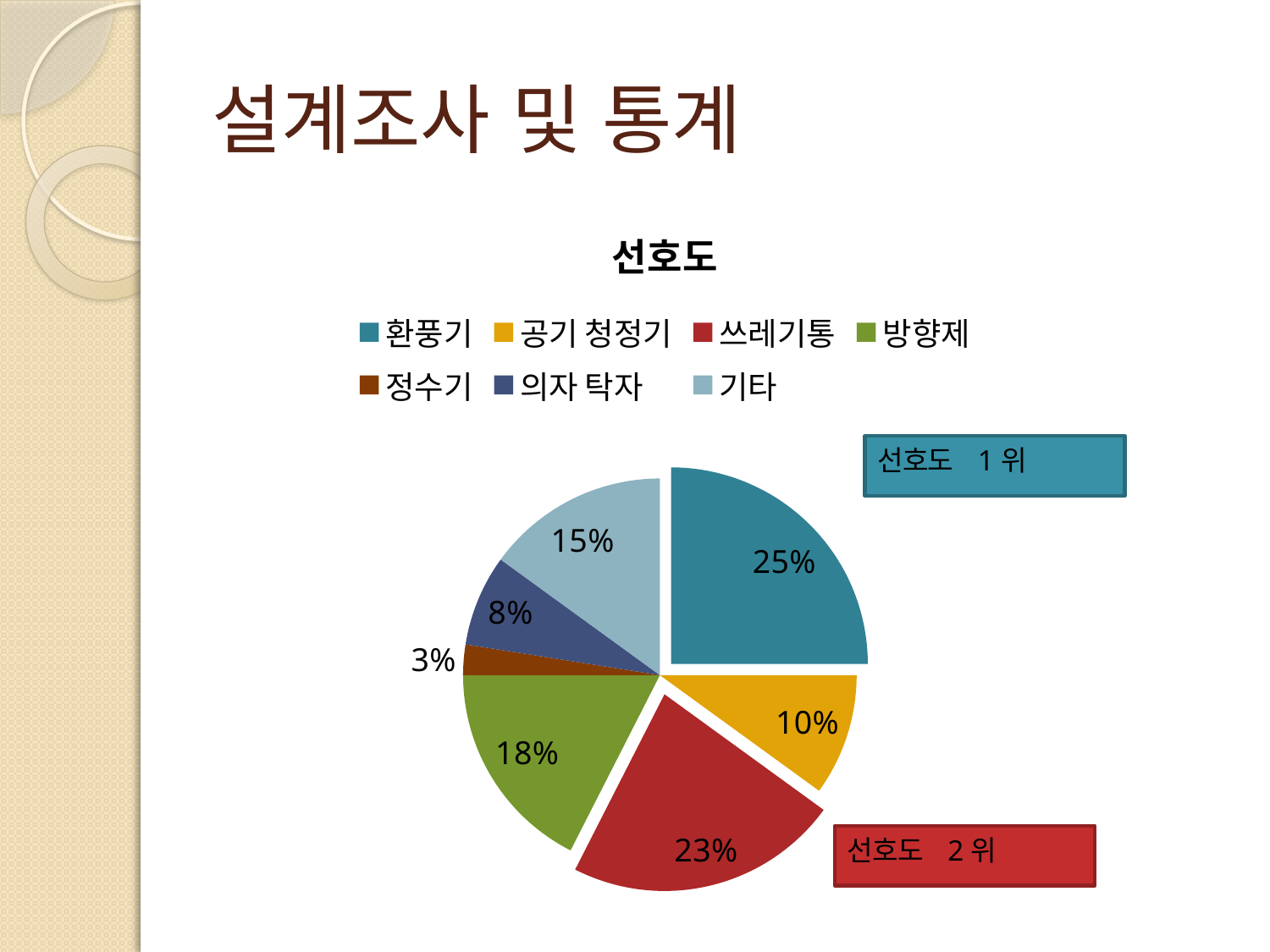
What kind of chart is shown on the slide? pie chart What is the title of the chart? 선호도 How many categories does the legend list? 7 What is the value shown for 방향제? 18% Which category has the largest share of the pie? 환풍기 What is the difference between the shares of 환풍기 and 쓰레기통? 2% What is the value shown for 쓰레기통? 23% What is the combined share of 정수기 and 의자 탁자? 11% Which category has the smallest share of the pie? 정수기 Which is larger, the share for 기타 or the share for 공기 청정기? 기타 What is the value shown for 의자 탁자? 8% What percentage of the pie does 환풍기 account for? 25%